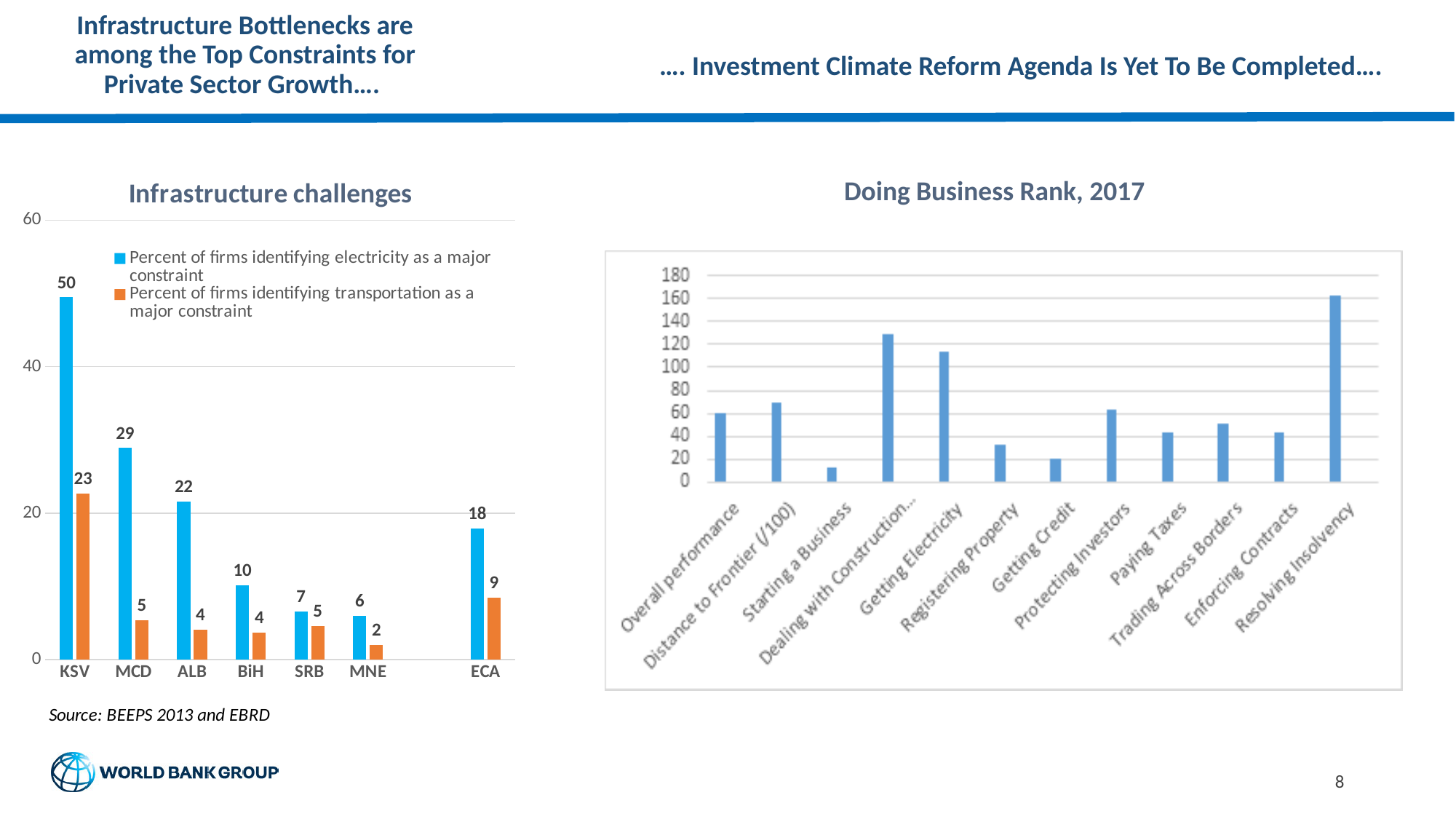
In the 'Infrastructure challenges' chart, what is the percent of firms identifying electricity as a major constraint for KSV? 50 In the 'Infrastructure challenges' chart, which is larger: the electricity value for ALB or the electricity value for ECA? ALB In the 'Doing Business Rank, 2017' chart, is the value for Getting Electricity greater or less than 100? greater What kind of chart is the 'Doing Business Rank, 2017' chart? bar chart In the 'Infrastructure challenges' chart, what is the difference between the electricity and transportation values for MCD? 24 How many series does the legend of the 'Infrastructure challenges' chart list? 2 In the 'Doing Business Rank, 2017' chart, which category has the highest value? Resolving Insolvency In the 'Infrastructure challenges' chart, which category has the highest percent of firms identifying electricity as a major constraint? KSV In the 'Doing Business Rank, 2017' chart, is the value for Starting a Business greater or less than 20? less In the 'Infrastructure challenges' chart, what is the percent of firms identifying transportation as a major constraint for ECA? 9 How many categories are shown on the x axis of the 'Infrastructure challenges' chart? 7 In the 'Infrastructure challenges' chart, which category has the lowest percent of firms identifying transportation as a major constraint? MNE